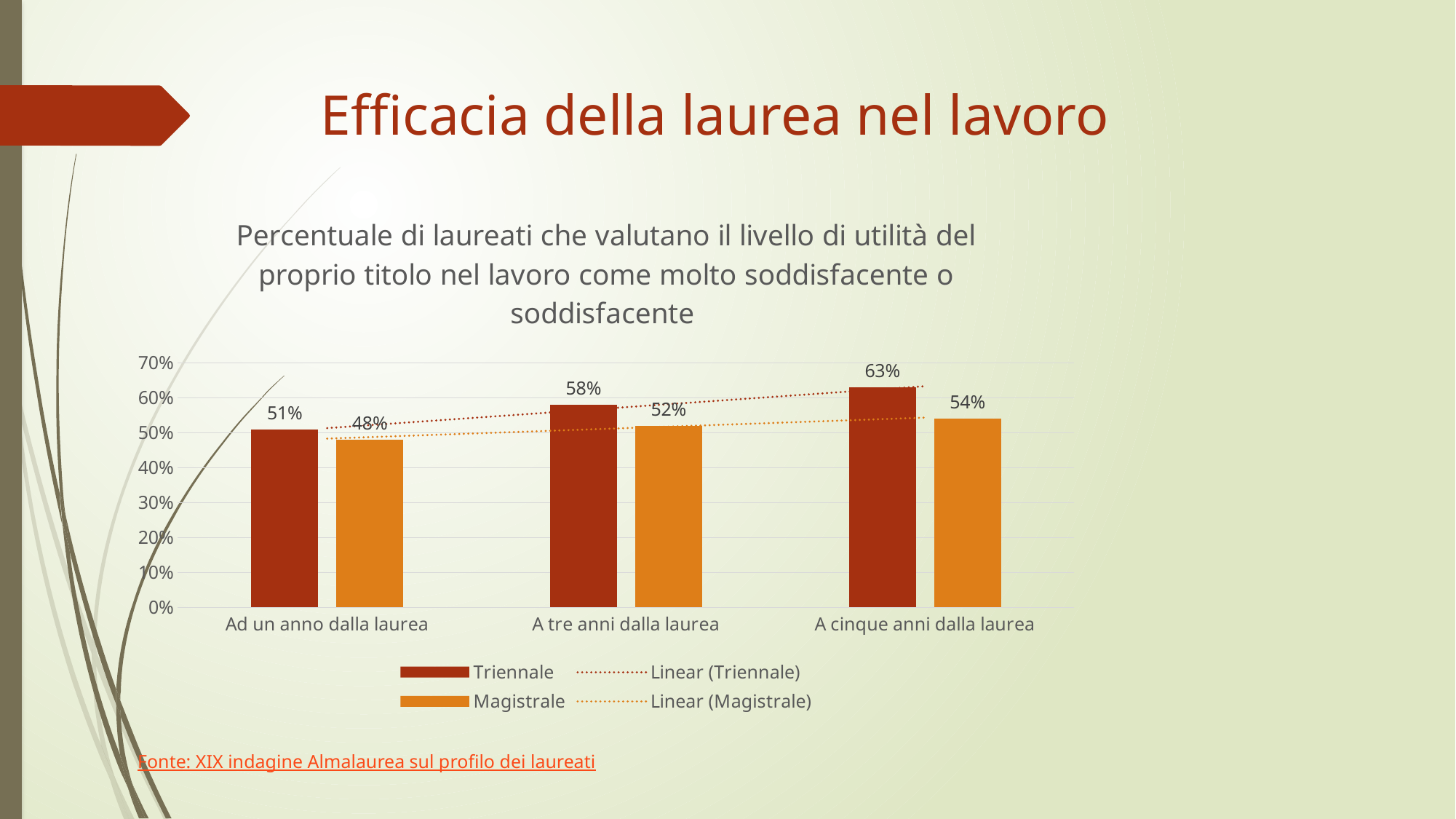
What kind of chart is shown on the slide? Bar chart Which category has the highest Triennale value? A cinque anni dalla laurea What is the Magistrale value for 'Ad un anno dalla laurea'? 48% What is the Triennale value for 'A cinque anni dalla laurea'? 63% What is the Magistrale value for 'A tre anni dalla laurea'? 52% How many entries does the legend list? 4 What is the Triennale value for 'Ad un anno dalla laurea'? 51% Which is larger for 'A tre anni dalla laurea': Triennale or Magistrale? Triennale Do the Triennale values rise or fall from 'Ad un anno dalla laurea' to 'A cinque anni dalla laurea'? Rise How many categories are shown on the x axis? 3 Which category has the lowest Magistrale value? Ad un anno dalla laurea What is the difference between the Triennale and Magistrale values for 'A cinque anni dalla laurea'? 9%